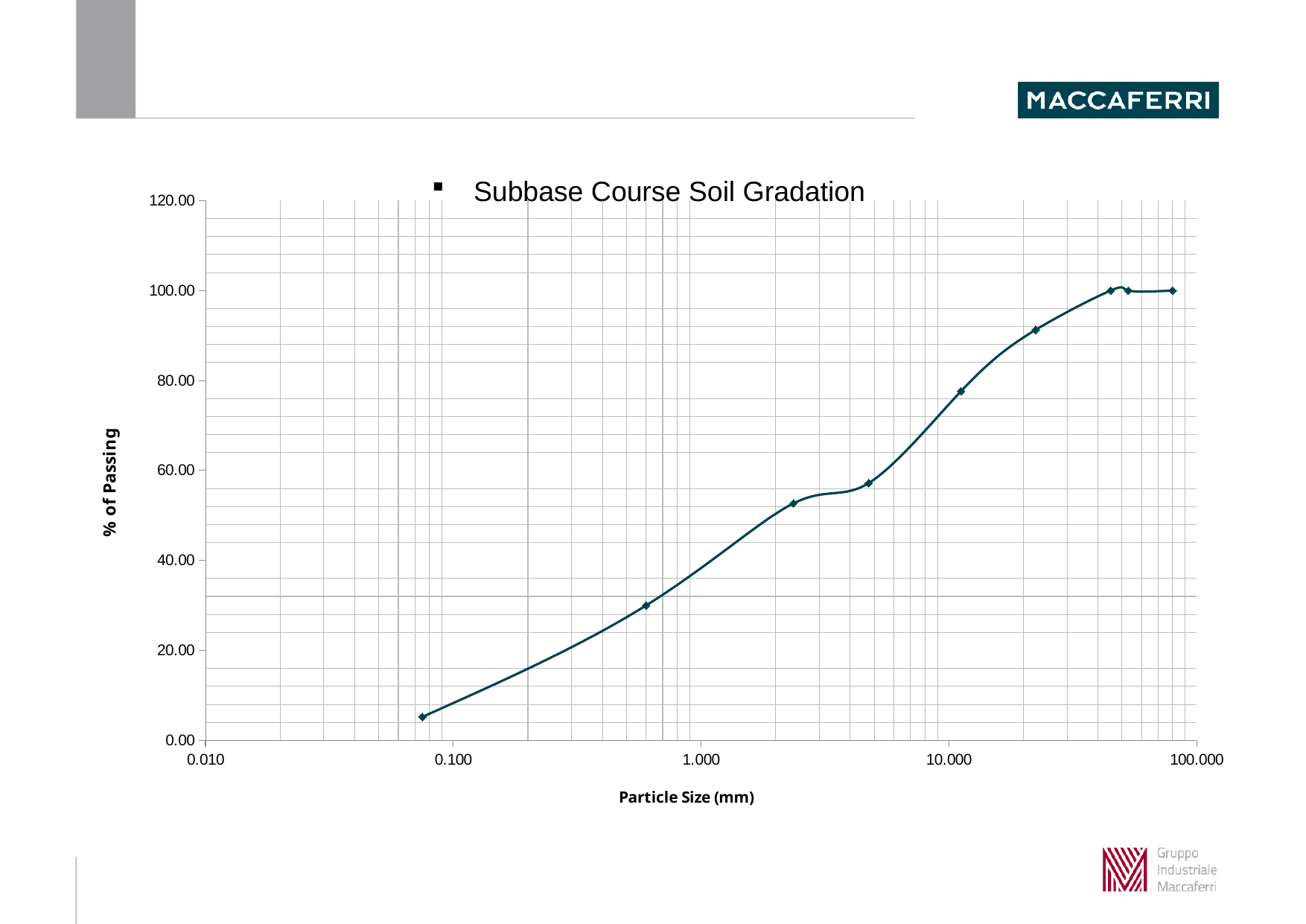
How many data points are plotted on the curve? 9 What kind of chart is shown on the slide? line chart What is the title of the chart? Subbase Course Soil Gradation Is the % of Passing at a particle size of 0.100 mm greater or less than 20.00? less Is the % of Passing at a particle size of 1.000 mm greater or less than 60.00? less Which has a higher % of Passing: the point near 1.000 mm or the point near 10.000 mm? the point near 10.000 mm What is the % of Passing at the largest particle size plotted? 100.00 Is the % of Passing at the smallest particle size plotted greater or less than 20.00? less What is the label of the x axis? Particle Size (mm) Does the % of Passing rise or fall as particle size increases along the x axis? rise What is the highest % of Passing value reached by the curve? 100.00